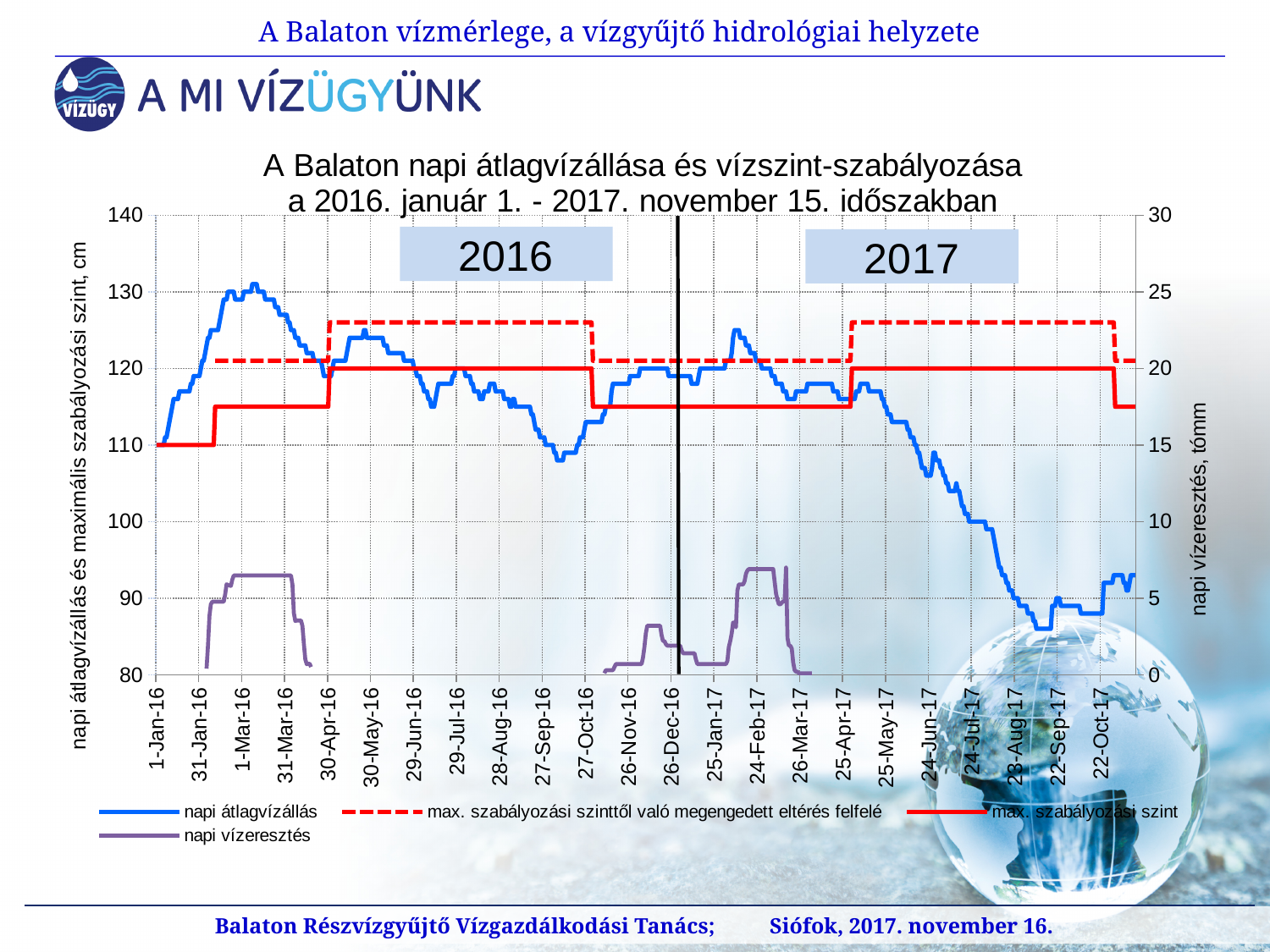
What is the value of the max. szabályozási szint series on 29-Jun-16? 120 Is the napi átlagvízállás value on 22-Sep-17 greater or less than 100? less Which series is drawn as a red dashed line? max. szabályozási szinttől való megengedett eltérés felfelé Which is larger, the napi átlagvízállás value on 1-Mar-16 or on 22-Sep-17? 1-Mar-16 What kind of chart is shown on the slide? line chart Is the napi átlagvízállás value on 1-Mar-16 greater or less than 120? greater What is the value of the max. szabályozási szint series on 1-Jan-16? 110 Does the napi átlagvízállás series rise or fall between 25-May-17 and 28-Aug-17? fall What is the title of the chart? A Balaton napi átlagvízállása és vízszint-szabályozása a 2016. január 1. - 2017. november 15. időszakban How many series does the chart legend list? 4 In which year does the napi átlagvízállás series reach its lowest point? 2017 Is the napi vízeresztés value on 24-Feb-17 greater or less than 5 on the right axis? greater